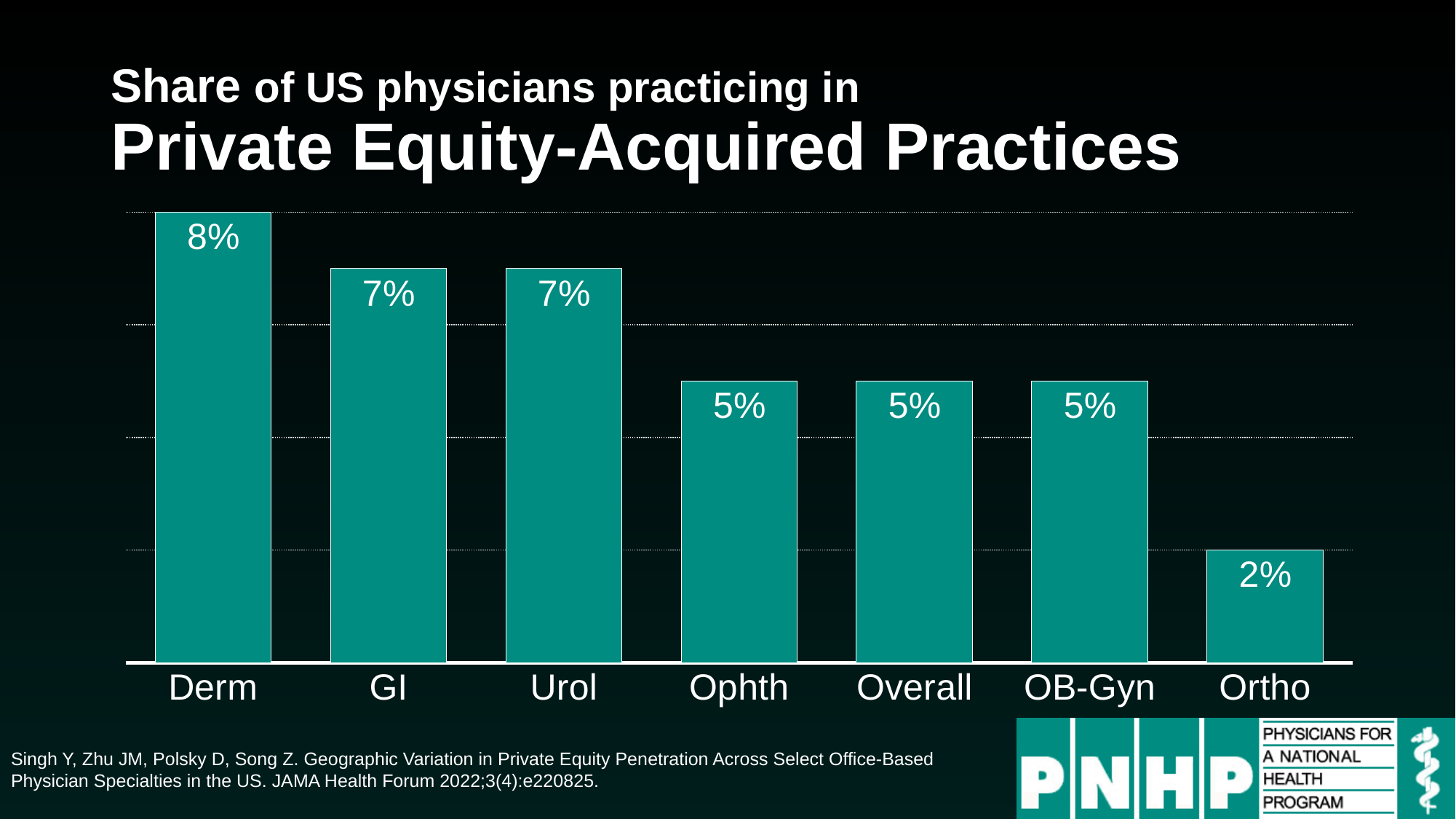
What value is shown for Ortho? 2% Which specialty has the lowest share of physicians in private equity-acquired practices? Ortho What is the difference between the values for GI and Ophth? 2% What value is shown for GI? 7% What is the value shown for Overall? 5% What kind of chart is shown on the slide? Bar chart Do the values generally rise or fall from left to right along the x axis? Fall What is the difference between the values for Derm and Ortho? 6% Which specialty has the highest share of physicians in private equity-acquired practices? Derm Which is larger, the value for Urol or the value for OB-Gyn? Urol What is the share of US physicians practicing in private equity-acquired practices for Derm? 8% How many categories are shown on the x axis? 7